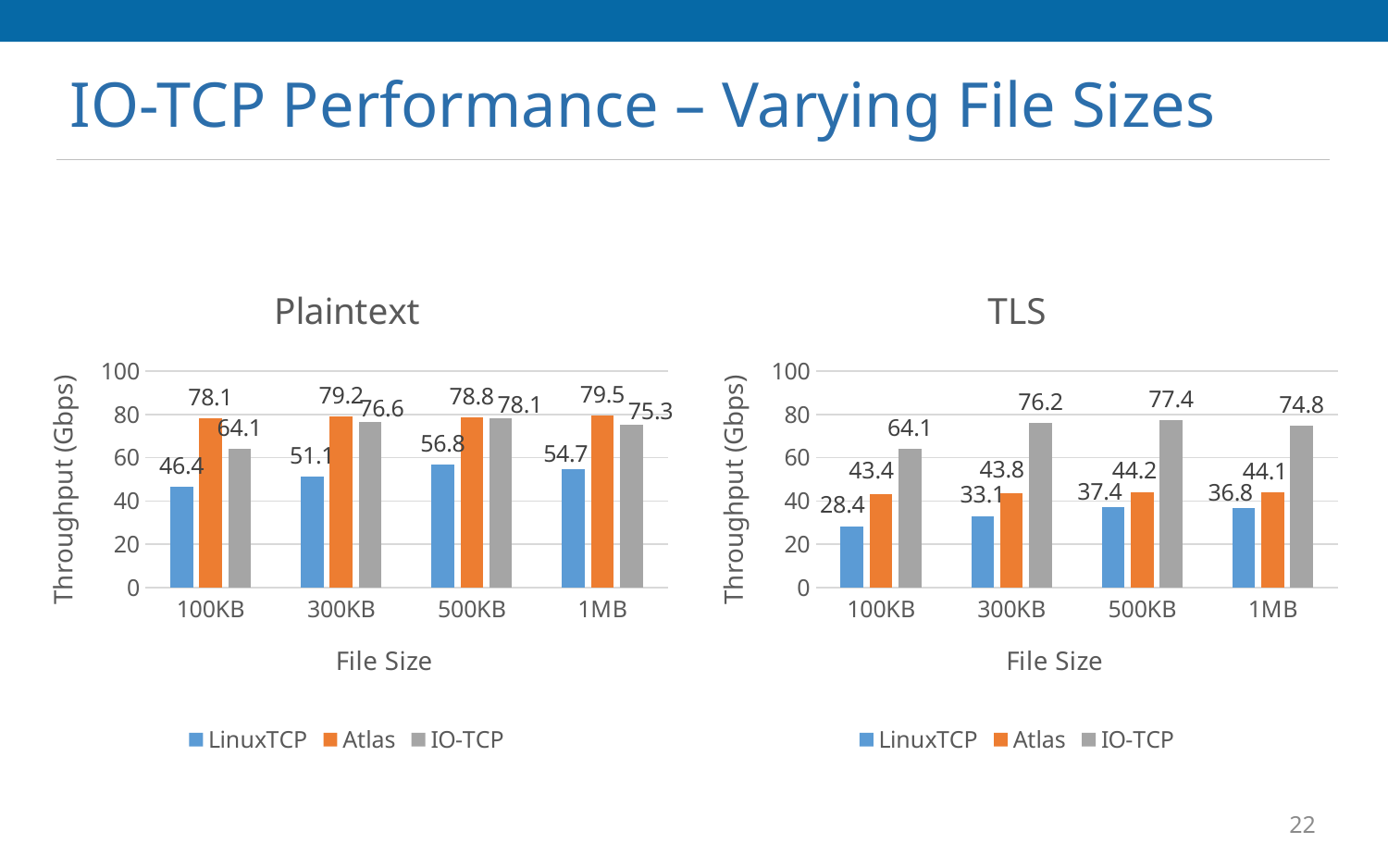
In the Plaintext chart, what is the throughput for Atlas at 100KB? 78.1 How many file size categories are shown on the x axis of the Plaintext chart? 4 In the Plaintext chart, what is the difference between the Atlas and LinuxTCP throughput at 1MB? 24.8 In the TLS chart, which is larger at 1MB: the Atlas throughput or the IO-TCP throughput? IO-TCP In the Plaintext chart, which file size has the highest LinuxTCP throughput? 500KB In the TLS chart, what is the throughput for LinuxTCP at 100KB? 28.4 In the TLS chart, what is the difference between the IO-TCP and Atlas throughput at 300KB? 32.4 In the TLS chart, which file size has the lowest IO-TCP throughput? 100KB What is the y-axis label of the TLS chart? Throughput (Gbps) What type of chart is the Plaintext chart? Bar chart In the TLS chart, what is the throughput for IO-TCP at 500KB? 77.4 How many series does the legend of the TLS chart list? 3